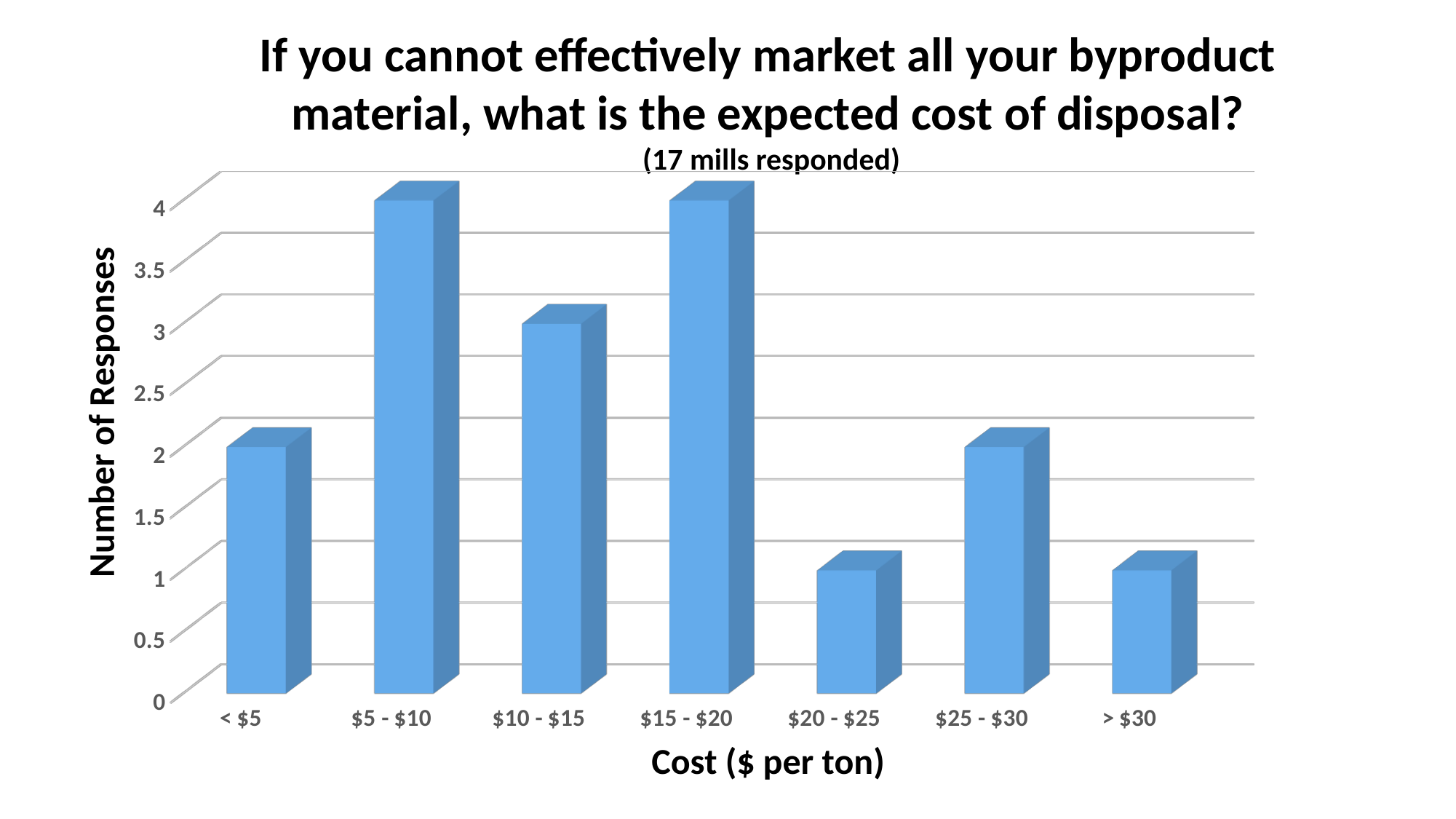
What is the number of responses for the $5 - $10 cost category? 4 Which has more responses, $15 - $20 or $10 - $15? $15 - $20 What kind of chart is shown on the slide? bar chart What is the difference in number of responses between $5 - $10 and $20 - $25? 3 What is the number of responses for the $10 - $15 cost category? 3 Which has more responses, $25 - $30 or > $30? $25 - $30 What is the number of responses for the $20 - $25 cost category? 1 Is the number of responses for $10 - $15 greater or less than 2? greater What is the label of the y axis? Number of Responses What is the number of responses for the < $5 cost category? 2 How many cost categories are shown on the x axis? 7 According to the chart subtitle, how many mills responded? 17